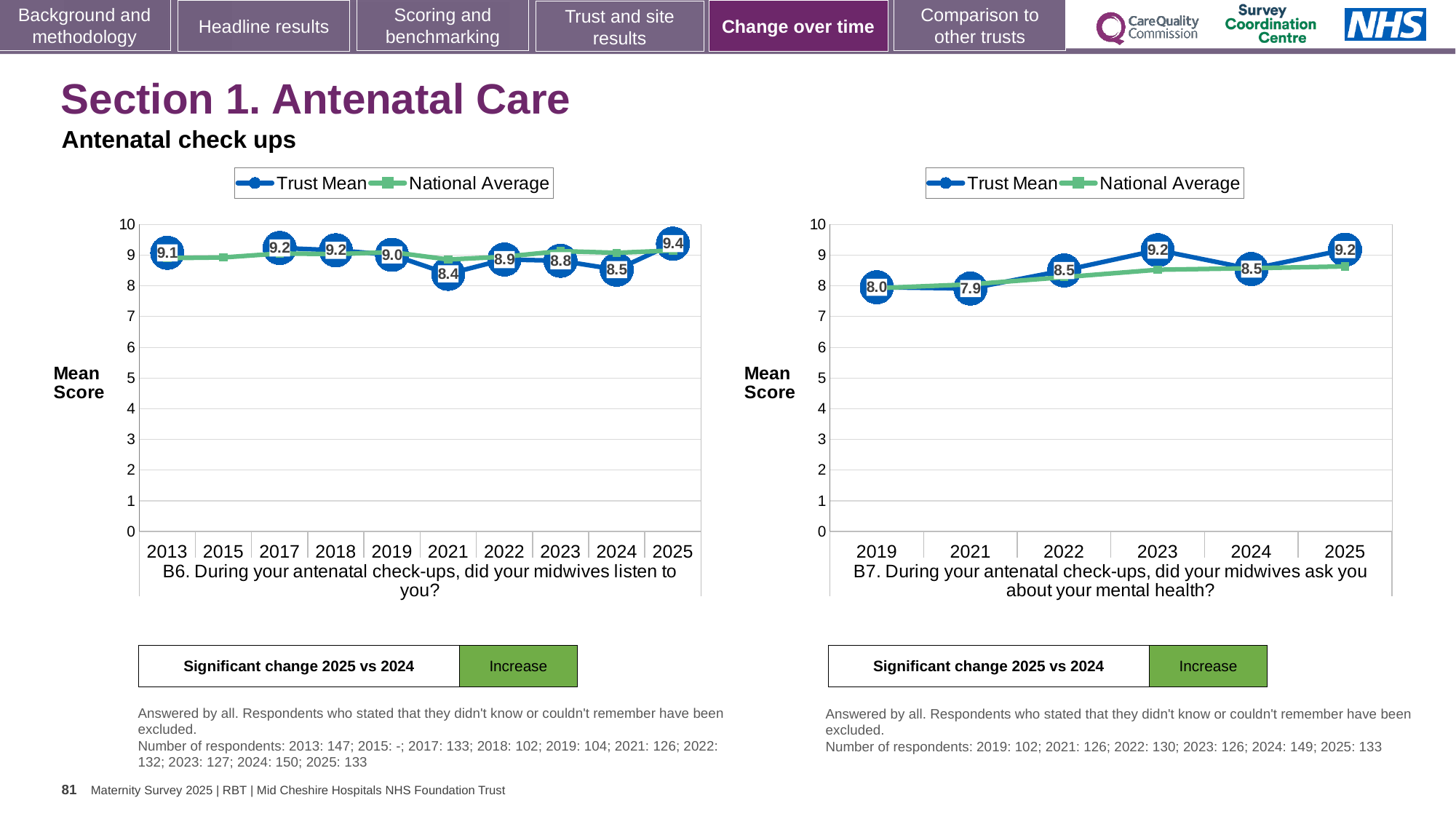
What type of chart is the B6 chart (left)? Line chart In the B7 chart (right), what is the difference between the Trust Mean for 2023 and 2022? 0.7 In the B7 chart (right), is the National Average for 2025 greater or less than 8? greater In the B6 chart (left), what is the difference between the Trust Mean for 2025 and 2024? 0.9 How many years are shown on the x axis of the B7 chart (right)? 6 In the B6 chart (left), what is the Trust Mean for 2021? 8.4 In the B7 chart (right), which year has the lowest Trust Mean? 2021 In the B7 chart (right), what is the Trust Mean for 2019? 8.0 How many series does the legend of the B6 chart (left) list? 2 In the B7 chart (right), is the Trust Mean higher in 2023 or in 2024? 2023 In the B6 chart (left), which year has the highest Trust Mean? 2025 In the B6 chart (left), what is the Trust Mean for 2025? 9.4